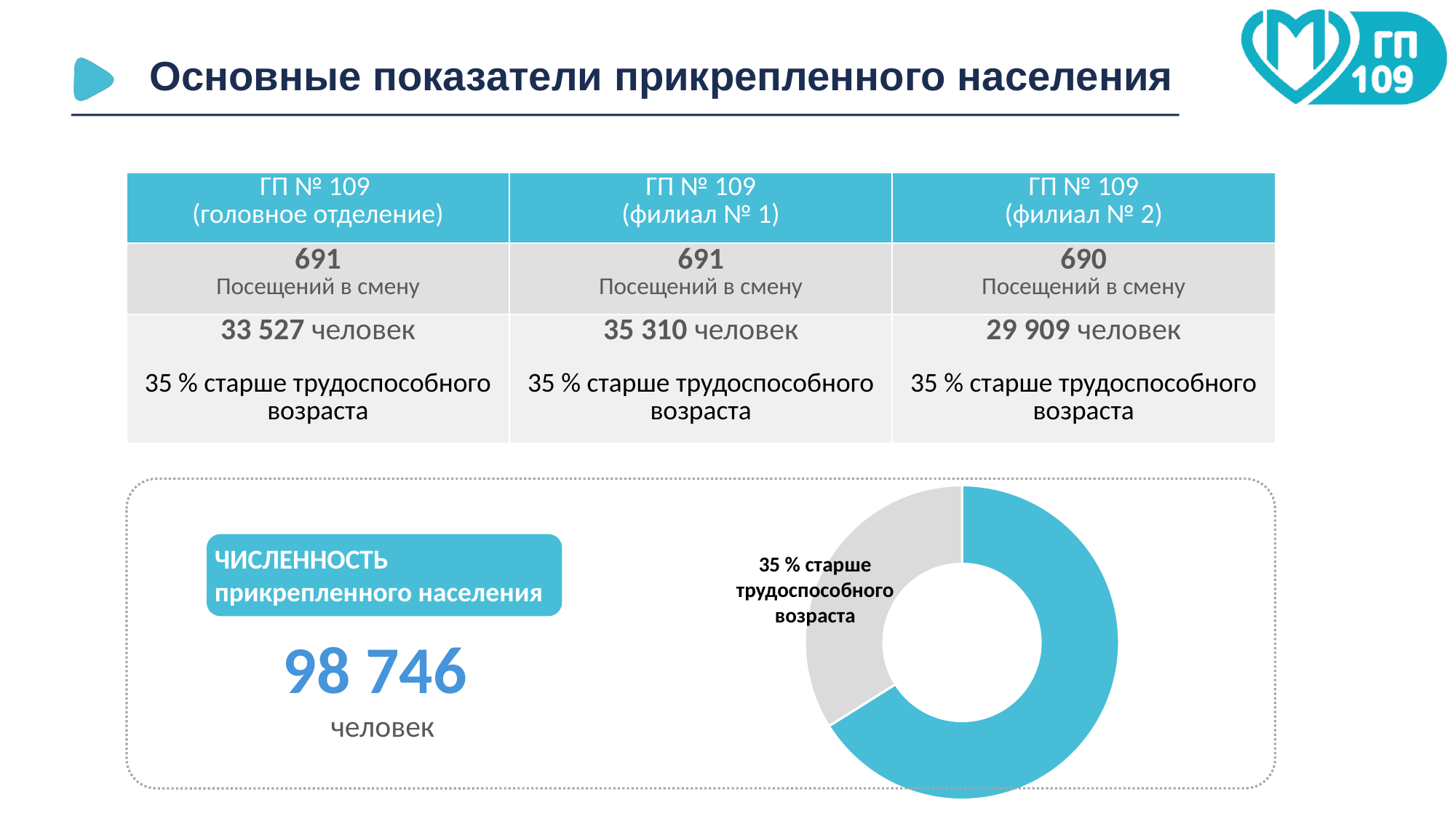
What does the grey slice of the donut chart represent? старше трудоспособного возраста How many slices does the donut chart have? 2 Is the blue slice of the donut chart greater or less than half of the chart? greater What is the only percentage value printed on the donut chart? 35 % Does the donut chart have a legend? No What kind of chart is shown at the bottom right of the slide? Pie chart (donut) Which slice of the donut chart is larger, the blue one or the grey one? The blue one What share of the donut chart does the grey slice represent? 35 %